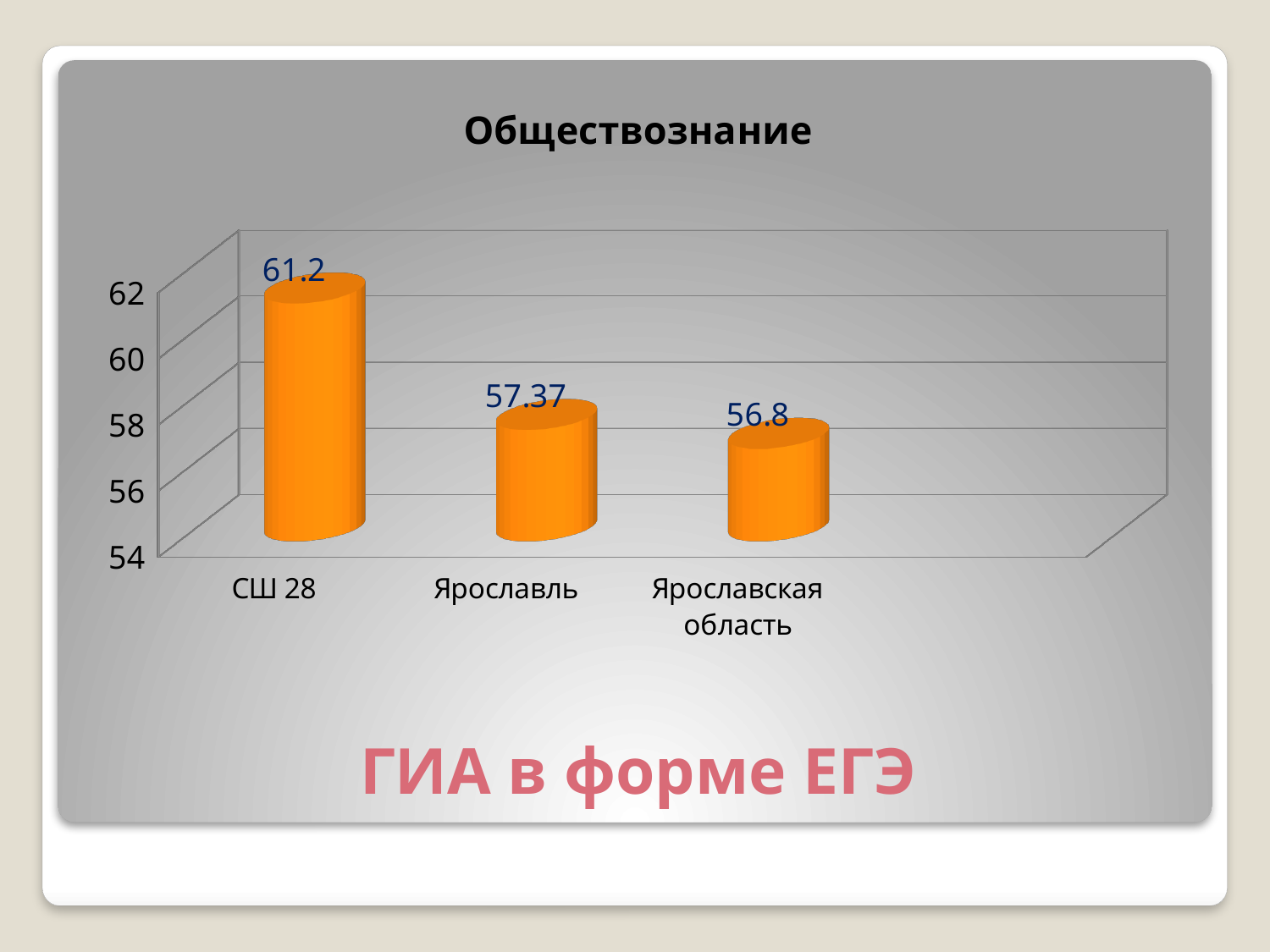
What is the title of the chart? Обществознание What is the value for СШ 28? 61.2 What is the value for Ярославская область? 56.8 What is the difference between the values for Ярославль and Ярославская область? 0.57 Which is larger, the value for СШ 28 or the value for Ярославль? СШ 28 What is the value for Ярославль? 57.37 How many categories are shown in the chart? 3 What is the difference between the values for СШ 28 and Ярославская область? 4.4 Is the value for Ярославль greater or less than 58? less What kind of chart is shown on the slide? bar chart Which category has the lowest value? Ярославская область Which category has the highest value? СШ 28